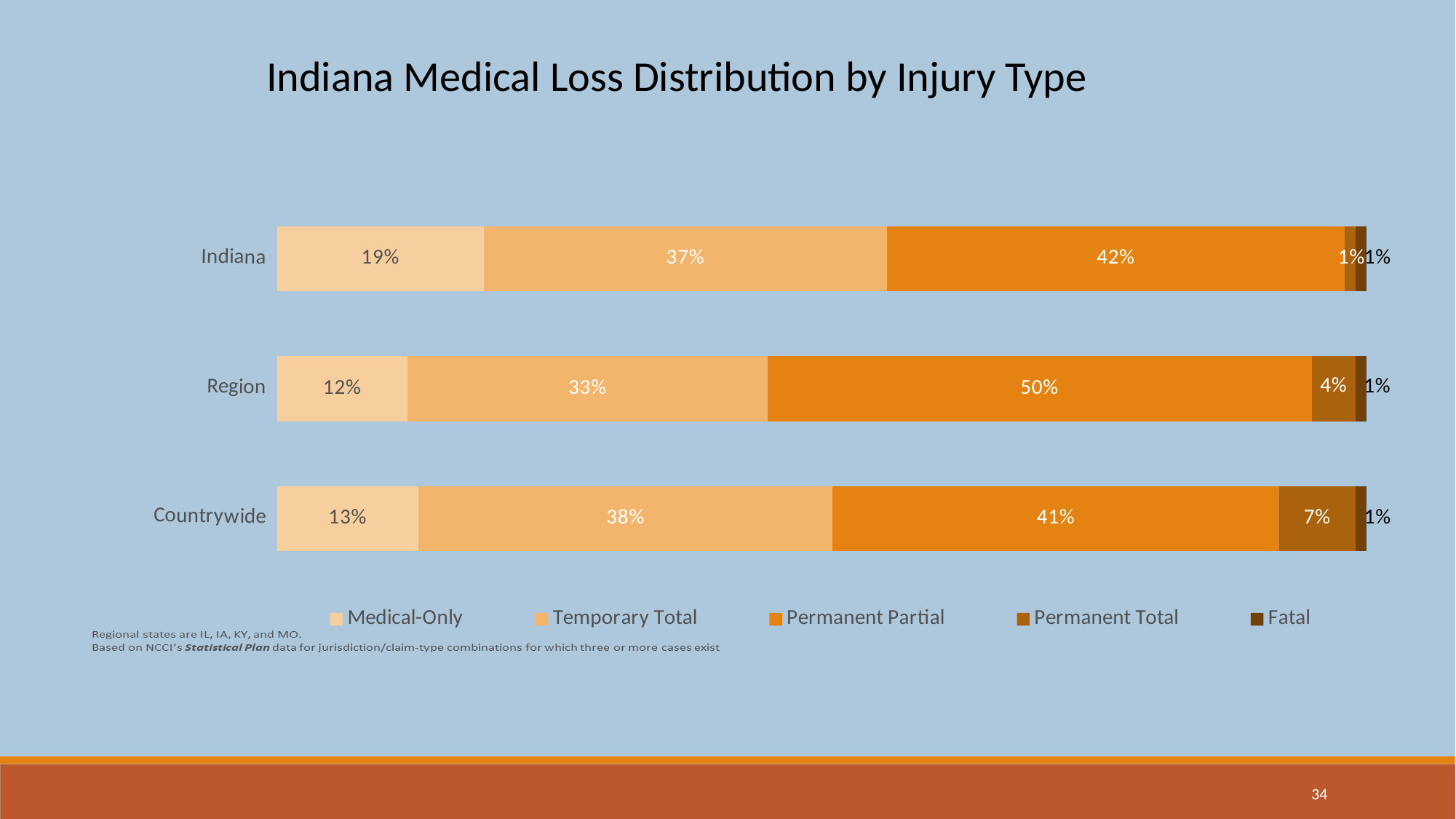
What is the Permanent Partial share for Region? 50% How many categories (bars) are shown in the chart? 3 What kind of chart is shown on the slide? Stacked bar chart Which is larger, the Temporary Total share for Indiana or for Countrywide? Countrywide What is the title of the chart? Indiana Medical Loss Distribution by Injury Type Which category has the highest Permanent Partial share? Region Which category has the lowest Medical-Only share? Region What is the Permanent Total share for Countrywide? 7% What is the Temporary Total share for Region? 33% How many series does the legend list? 5 What is the Medical-Only share for Indiana? 19% What is the difference between the Permanent Partial share for Region and for Countrywide? 9%